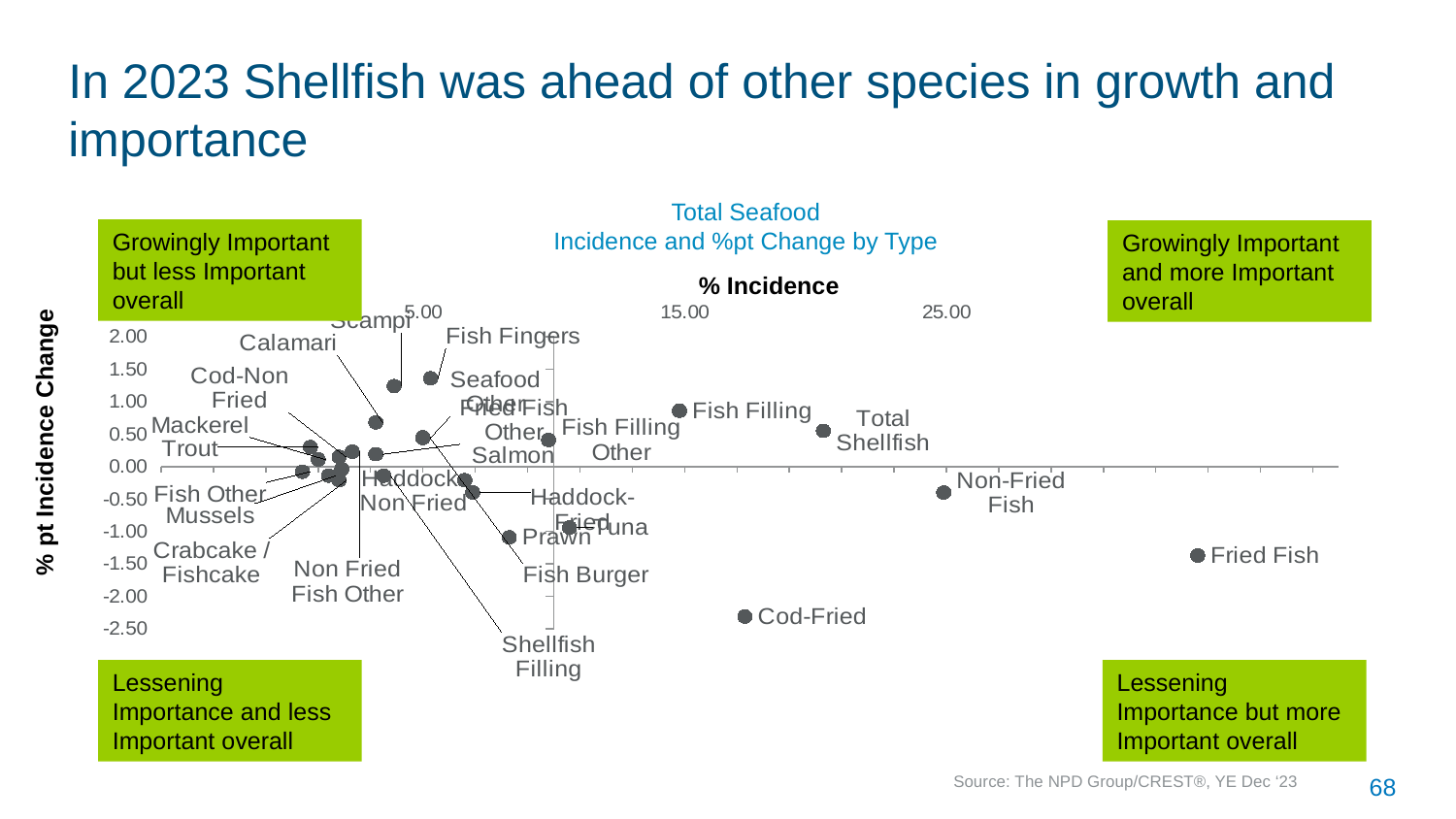
Is the % pt Incidence Change for Cod-Fried greater or less than -2.00? less Is the % pt Incidence Change for Total Shellfish greater or less than 0.00? greater What kind of chart is shown on the slide? Scatter chart Is the % Incidence for Fried Fish greater or less than 25.00? greater What is the label of the horizontal axis of the chart? % Incidence Which seafood type has the lowest % pt Incidence Change? Cod-Fried Which has the higher % Incidence, Fried Fish or Cod-Fried? Fried Fish What is the title of the chart? Total Seafood Incidence and %pt Change by Type Which has the higher % pt Incidence Change, Total Shellfish or Non-Fried Fish? Total Shellfish Which seafood type has the highest % Incidence? Fried Fish